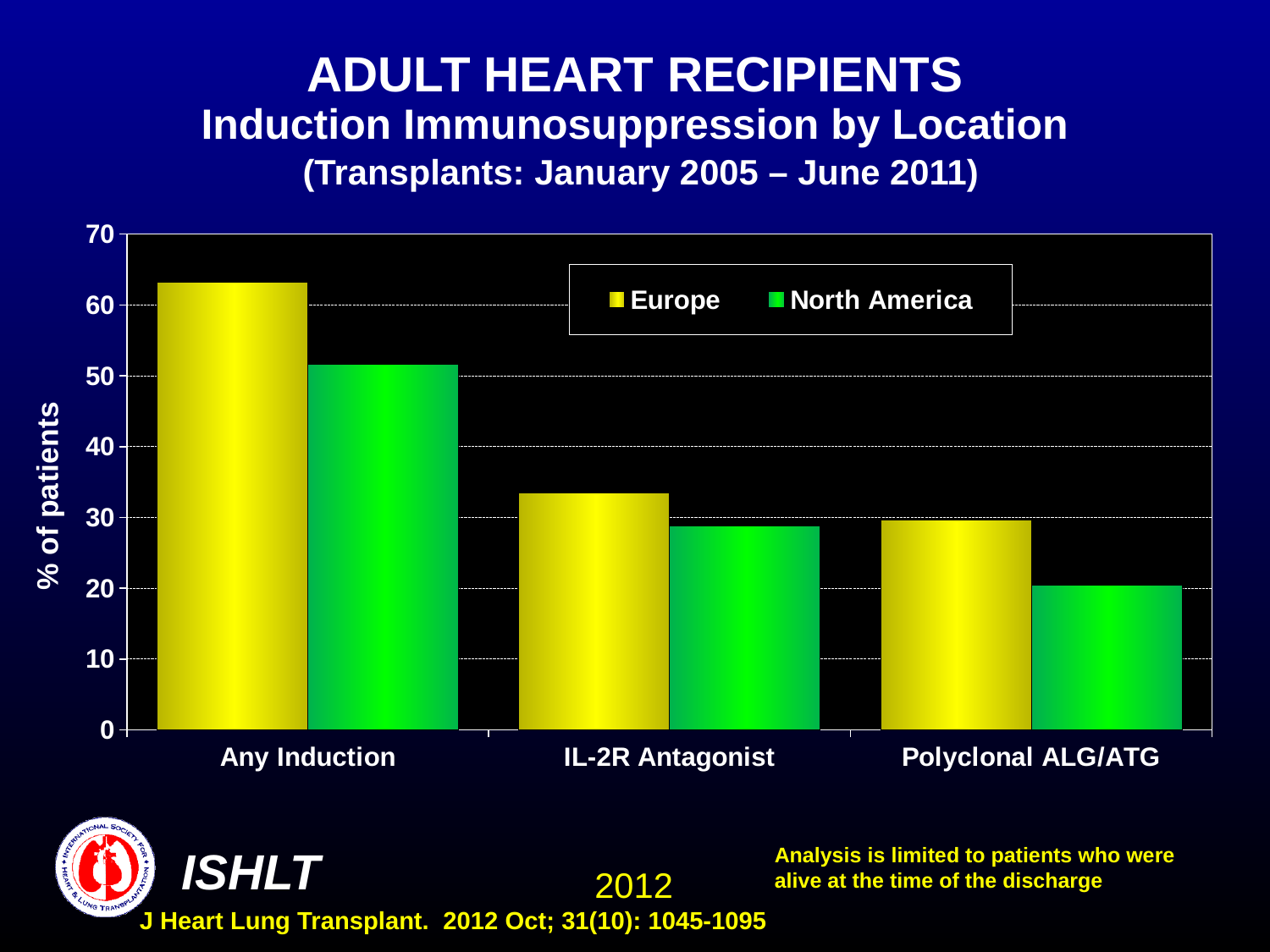
In the Polyclonal ALG/ATG category, which region has the larger value, Europe or North America? Europe What is the y-axis label of the chart? % of patients Is the value for North America in the Polyclonal ALG/ATG category greater or less than 30? less Is the value for North America in the Any Induction category greater or less than 40? greater Which series does the legend list first? Europe Is the value for Europe in the IL-2R Antagonist category greater or less than 30? greater What kind of chart is shown on the slide? bar chart Which category has the lowest value for Europe? Polyclonal ALG/ATG Which category has the highest value for North America? Any Induction How many series does the legend list? 2 How many categories are shown on the x axis? 3